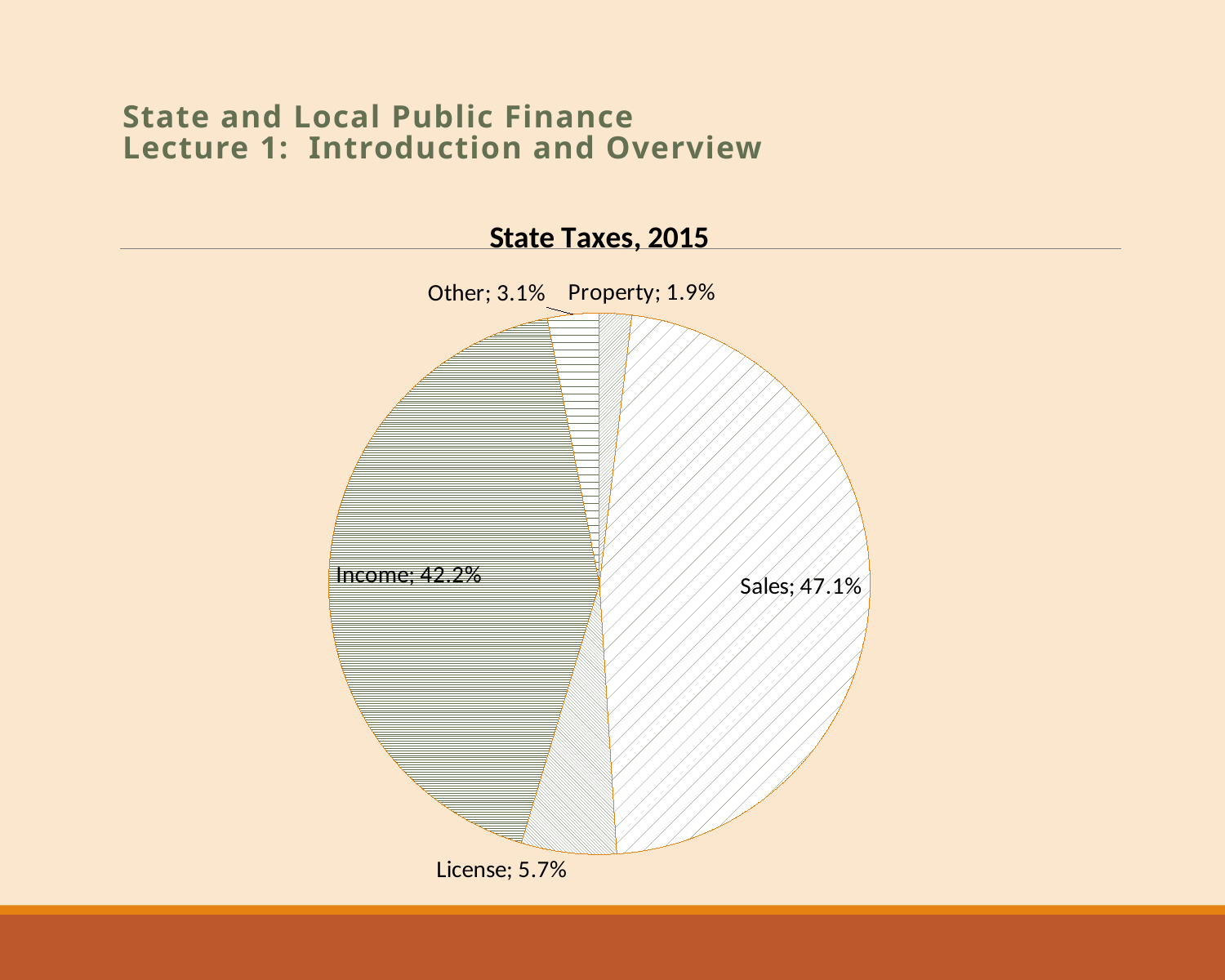
Which category has the smallest share of state taxes in 2015? Property Which category has the largest share of state taxes in 2015? Sales What is the title of the chart? State Taxes, 2015 Which is larger, the share for License or the share for Other? License What share of state taxes in 2015 comes from Sales? 47.1% What kind of chart is shown on the slide? Pie chart What share of state taxes in 2015 comes from Income? 42.2% What share of state taxes in 2015 comes from Other? 3.1% What share of state taxes in 2015 comes from Property? 1.9% What is the difference in percentage points between the Sales and Income shares? 4.9 How many categories are shown in the pie chart? 5 What share of state taxes in 2015 comes from License? 5.7%